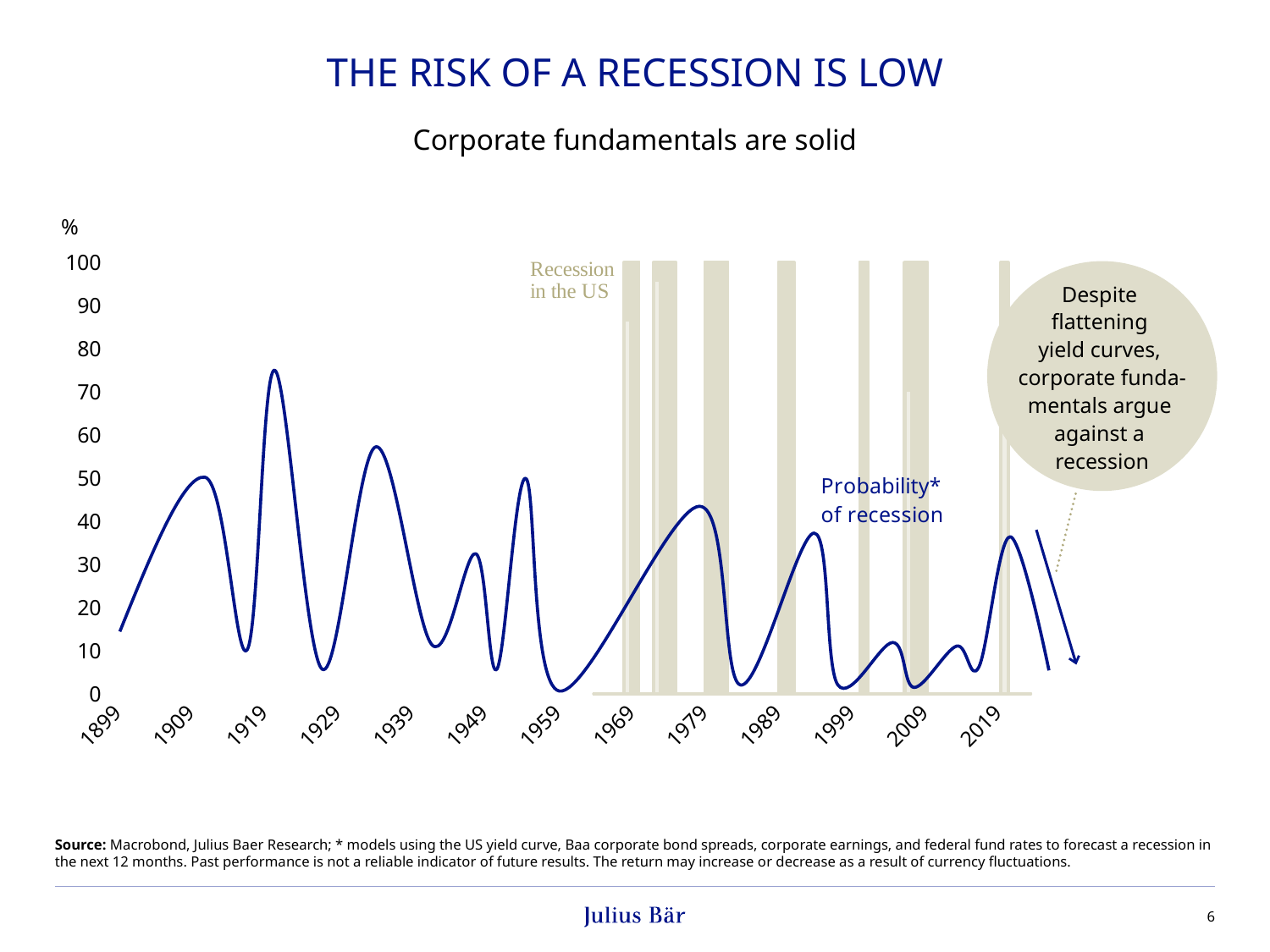
How many year labels are shown on the x axis? 13 What unit is shown on the y axis of the chart? % Does the probability of recession line rise or fall between 1959 and 1979? rise What is the highest value shown on the y axis? 100 What do the shaded vertical bars on the chart represent, according to the label? Recession in the US What kind of chart is shown on the slide? line chart Is the value of the probability of recession line at 1899 greater or less than 20? less What is the first year labelled on the x axis? 1899 What is the title of the slide containing the chart? THE RISK OF A RECESSION IS LOW Is the highest peak of the probability of recession line greater or less than 70? greater What is the last year labelled on the x axis? 2019 Is the value of the probability of recession line around 1959 greater or less than 10? less